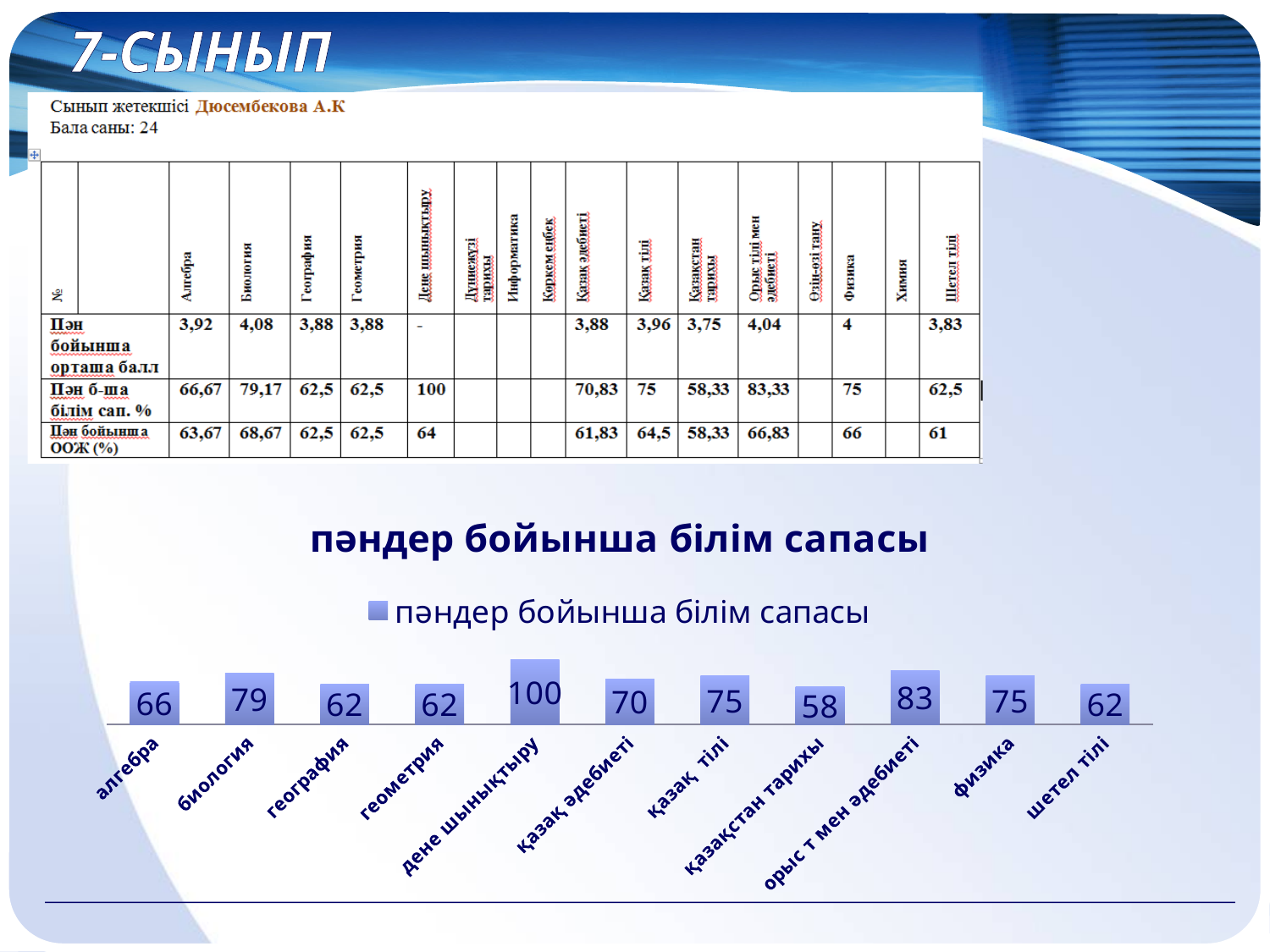
What is the value for орыс т мен әдебиеті in the chart? 83 How many categories are shown in the chart? 11 What is the value for қазақстан тарихы in the chart? 58 What is the value for дене шынықтыру in the chart? 100 What is the title of the chart? пәндер бойынша білім сапасы What kind of chart is shown on the slide? bar chart How many series does the chart legend list? 1 Which category has the lowest value in the chart? қазақстан тарихы Which category has the highest value in the chart? дене шынықтыру What is the difference between the values for дене шынықтыру and алгебра? 34 Which is larger, the value for биология or the value for физика? биология What is the value for биология in the chart? 79